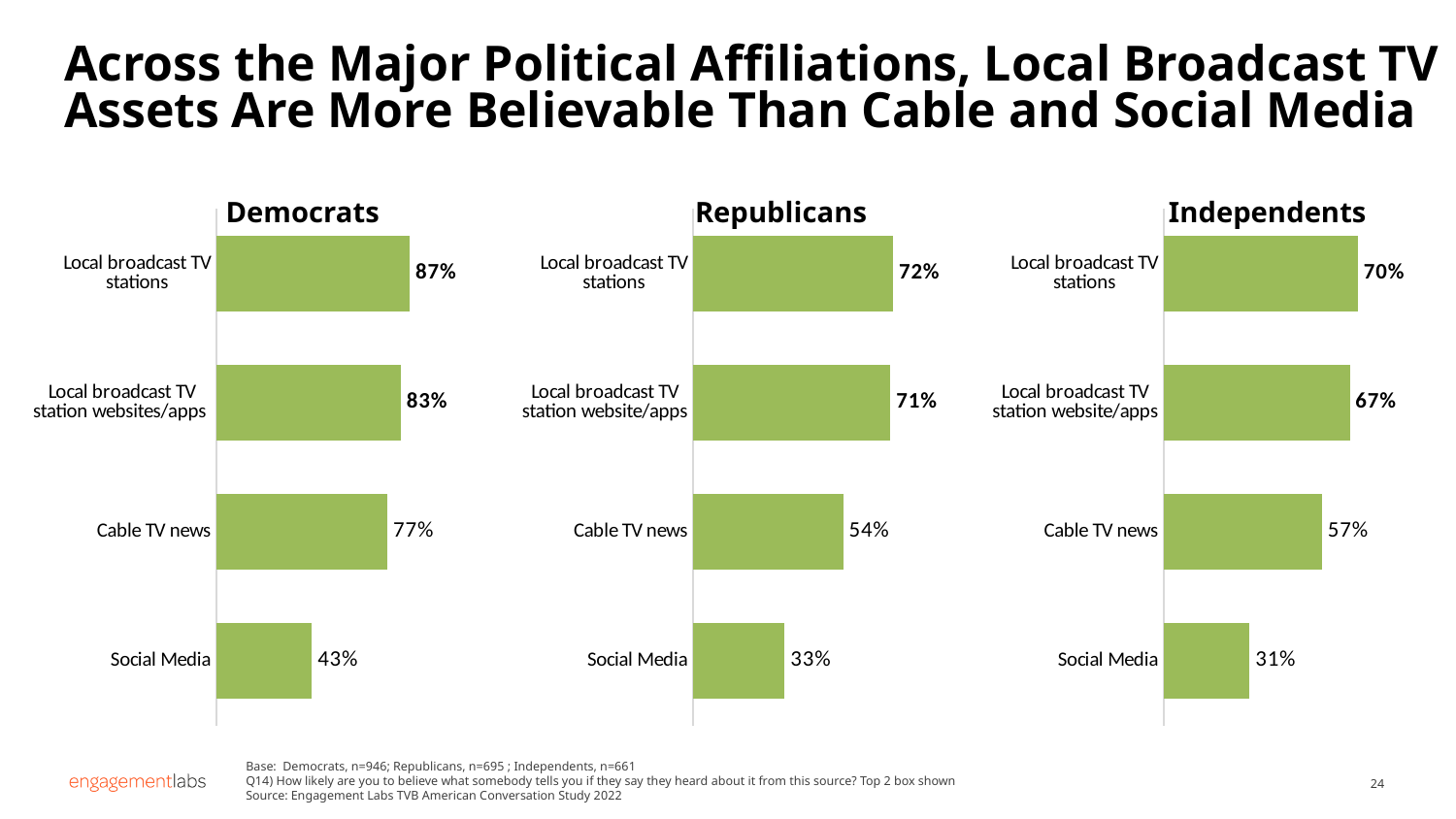
In the Independents chart, what is the value for Social Media? 31% In the Democrats chart, what is the difference between Local broadcast TV stations and Social Media? 44% What type of chart is the Democrats chart? Bar chart How many categories are shown in the Republicans chart? 4 How many charts are on the slide? 3 In the Republicans chart, what is the difference between Local broadcast TV station website/apps and Cable TV news? 17% Which is larger: Cable TV news in the Democrats chart or Cable TV news in the Independents chart? Democrats In the Republicans chart, what is the value for Cable TV news? 54% In the Democrats chart, what is the value for Local broadcast TV stations? 87% In the Republicans chart, which category has the lowest value? Social Media In the Independents chart, which category has the highest value? Local broadcast TV stations In the Independents chart, what is the value for Local broadcast TV station website/apps? 67%